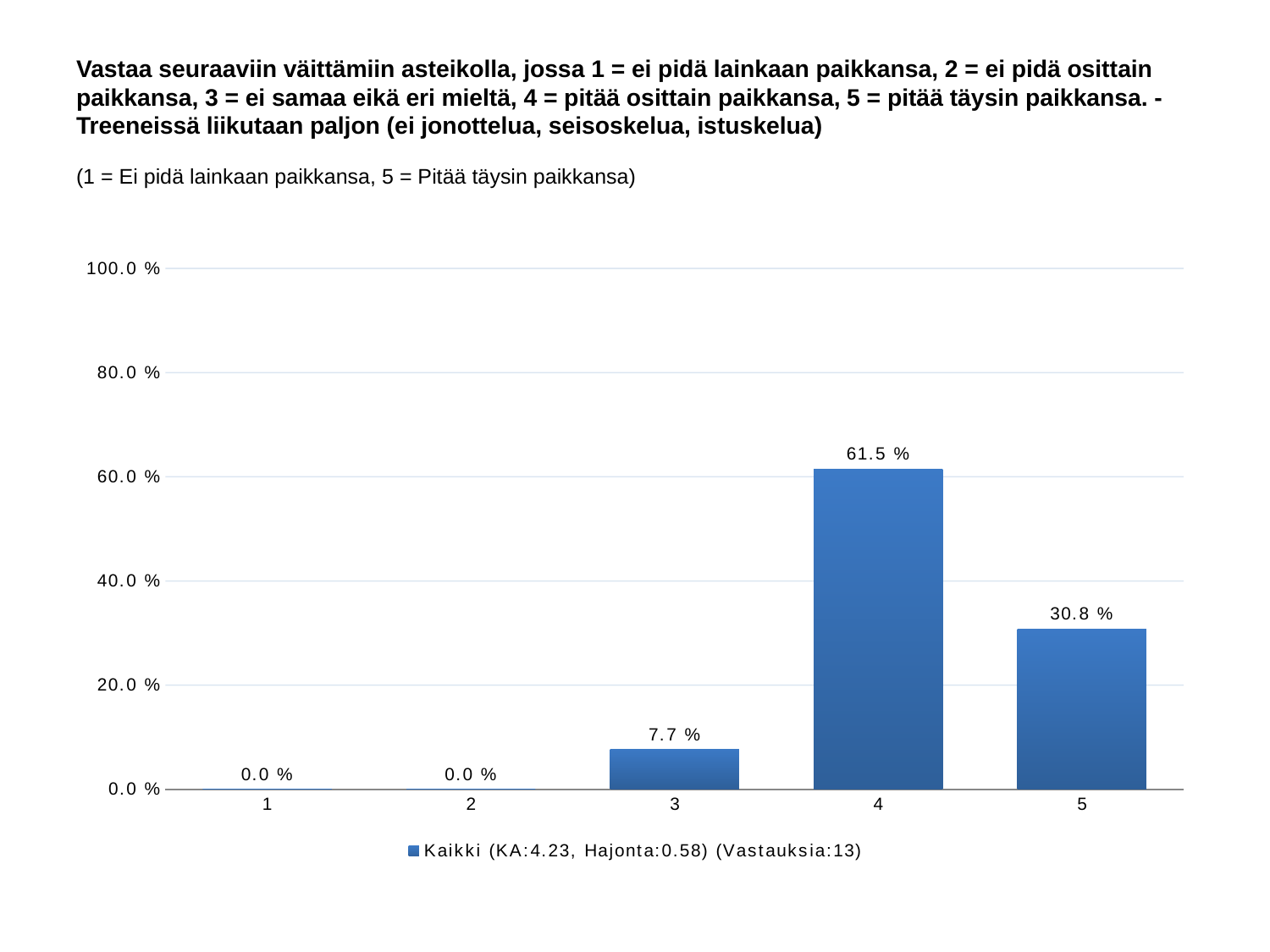
What is the value for category 3? 7.7 % What is the value for category 4? 61.5 % Is the value for category 4 greater or less than 60.0 %? greater What is the difference between the values for categories 4 and 5? 30.7 % Which category has the highest value? 4 How many responses (Vastauksia) does the legend entry report? 13 How many categories are shown on the x axis? 5 Which is larger, the value for category 3 or the value for category 5? 5 What kind of chart is shown? bar chart How many series does the legend list? 1 What is the value for category 5? 30.8 % What is the value for category 1? 0.0 %